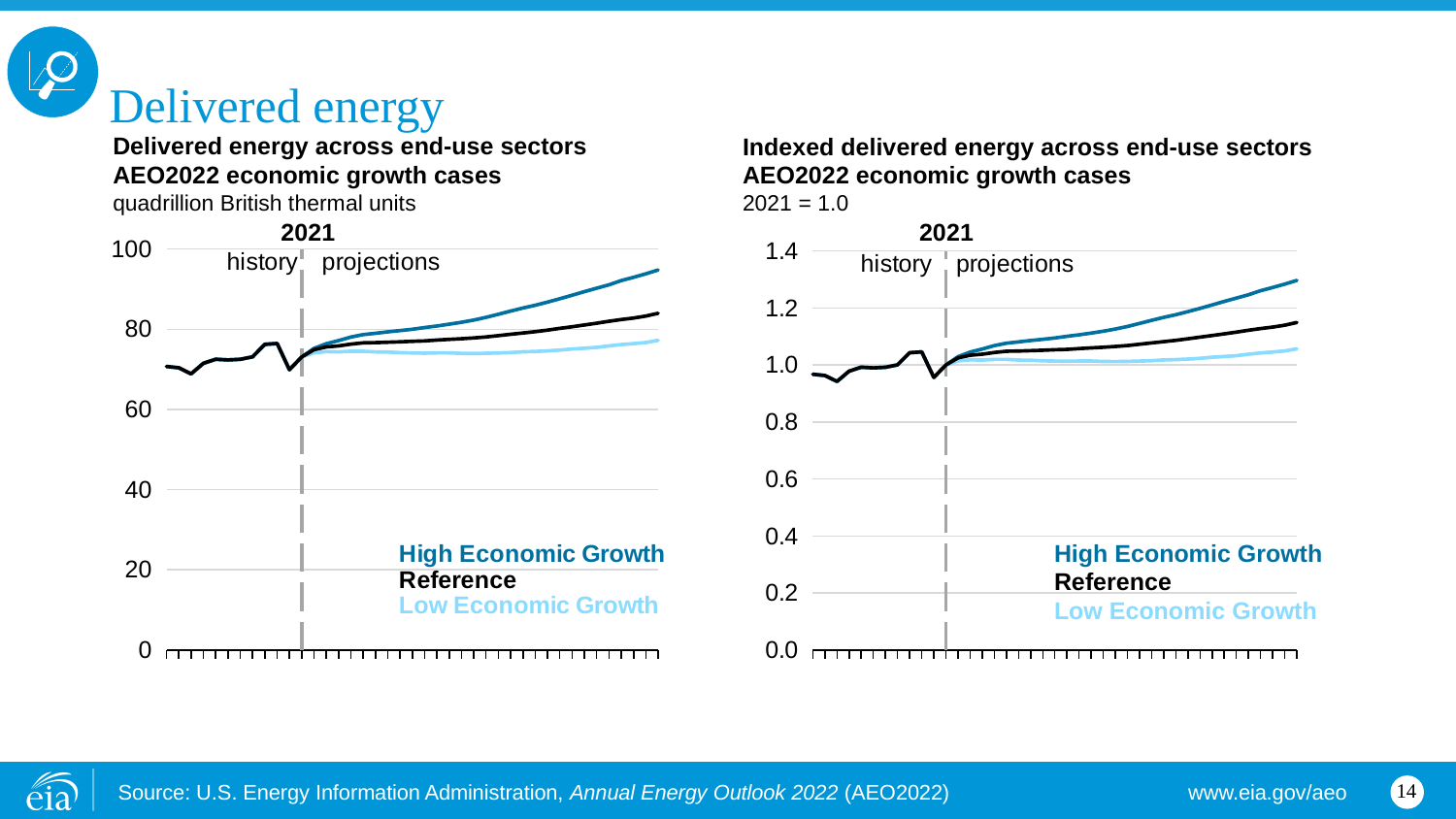
In the left chart, 'Delivered energy across end-use sectors', is the value for High Economic Growth at the end of the projections greater or less than 80? greater In the left chart, 'Delivered energy across end-use sectors', which is larger at the end of the projections: High Economic Growth or Low Economic Growth? High Economic Growth In the right chart, 'Indexed delivered energy across end-use sectors', which series is lowest at the end of the projection period? Low Economic Growth What kind of chart is the left chart, 'Delivered energy across end-use sectors'? line chart In the left chart, 'Delivered energy across end-use sectors', which series is highest at the end of the projection period? High Economic Growth In the left chart, 'Delivered energy across end-use sectors', is the value for Low Economic Growth at the end of the projections greater or less than 80? less How many series are shown in the right chart, 'Indexed delivered energy across end-use sectors'? 3 In the right chart, 'Indexed delivered energy across end-use sectors', is the value for High Economic Growth at the end of the projections greater or less than 1.2? greater In the right chart, 'Indexed delivered energy across end-use sectors', does the High Economic Growth line rise or fall over the projection period? rise In the right chart, 'Indexed delivered energy across end-use sectors', what is the index value in 2021? 1.0 What unit is used on the left chart, 'Delivered energy across end-use sectors'? quadrillion British thermal units